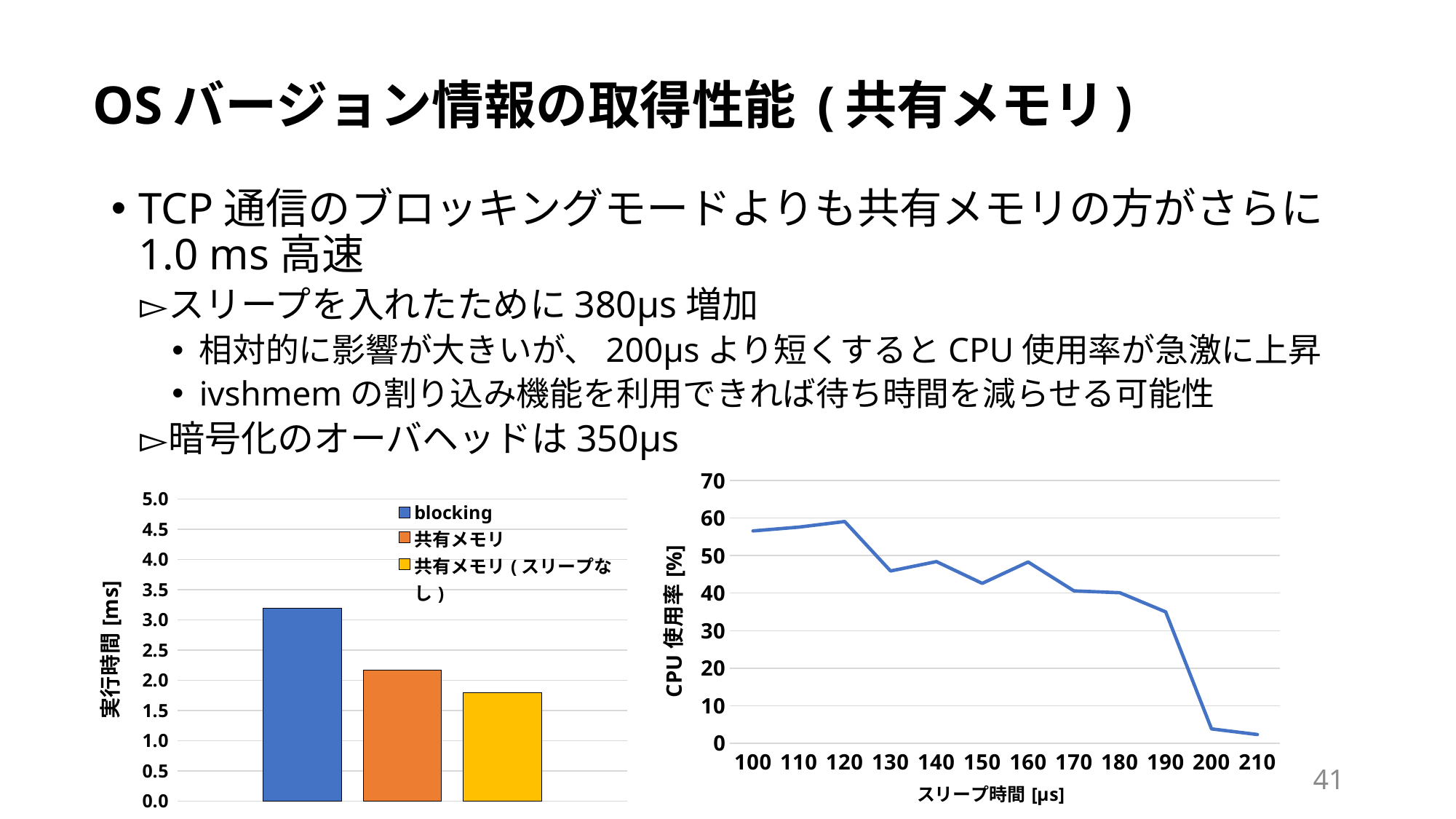
In the left bar chart, which series has the lowest 実行時間? 共有メモリ ( スリープなし ) In the left bar chart, is the value for 共有メモリ greater or less than 2.5? less In the left bar chart, which series has the highest 実行時間? blocking What kind of chart is the left chart on the slide? bar chart In the right line chart, at which スリープ時間 is CPU 使用率 highest? 120 In the right line chart, how many スリープ時間 points are plotted along the x axis? 12 What kind of chart is the right chart (CPU 使用率 vs スリープ時間)? line chart In the left bar chart, which is larger, the value for 共有メモリ or the value for 共有メモリ ( スリープなし )? 共有メモリ In the left bar chart, is the value for blocking greater or less than 3.0? greater In the right line chart, does CPU 使用率 generally rise or fall as スリープ時間 increases? fall In the left bar chart, how many series does the legend list? 3 In the right line chart, is the CPU 使用率 at スリープ時間 200 greater or less than 10? less